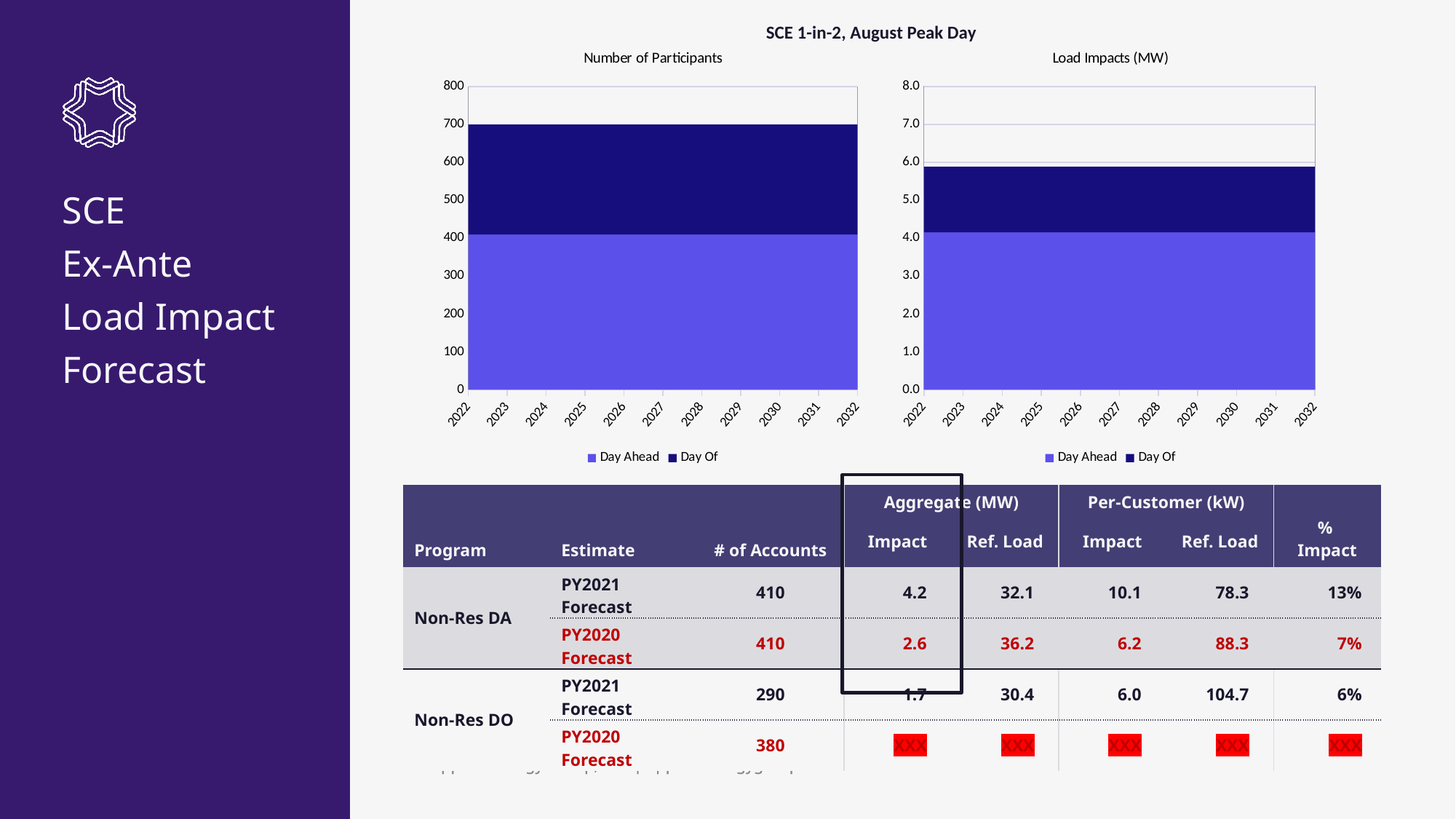
In the "Number of Participants" chart, is the Day Ahead value for 2025 greater or less than 300? greater What is the overall title shown above the two charts? SCE 1-in-2, August Peak Day In the "Load Impacts (MW)" chart, is the total stacked bar height for 2030 greater or less than 7.0? less In the "Number of Participants" chart, do the stacked totals rise, fall, or stay flat from 2022 to 2032? stay flat In the "Load Impacts (MW)" chart, do the stacked totals rise, fall, or stay flat across the years? stay flat What kind of chart is the "Load Impacts (MW)" chart? stacked area chart In the "Load Impacts (MW)" chart, is the Day Ahead value for 2022 greater or less than 3.0? greater Which series is shown in the darker blue colour in the "Load Impacts (MW)" chart? Day Of What kind of chart is the "Number of Participants" chart? stacked area chart How many series does the legend of the "Number of Participants" chart list? 2 How many years are shown on the x axis of the "Load Impacts (MW)" chart? 11